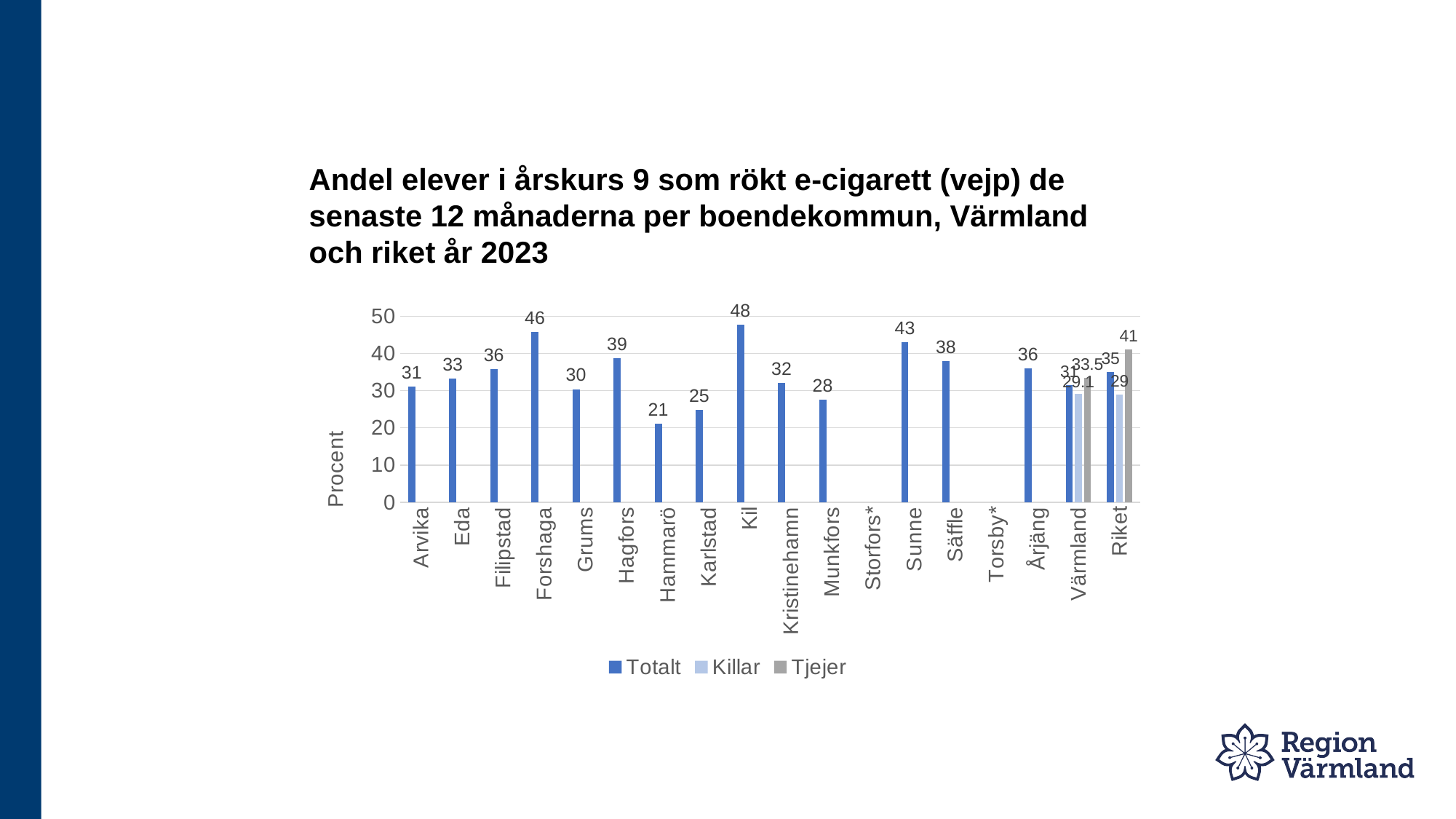
How many series does the legend list? 3 How many categories are shown on the x axis? 18 What is the Tjejer value for Riket? 41 What is the difference between the Tjejer and Killar values for Riket? 12 Which municipality has the highest Totalt value? Kil What is the Totalt value for Kil? 48 What is the Killar value for Värmland? 29.1 What are the three legend entries of the chart? Totalt, Killar, Tjejer What is the difference between the Totalt values for Forshaga and Grums? 16 Which has a higher Totalt value, Sunne or Säffle? Sunne Which municipality has the lowest plotted Totalt value? Hammarö What kind of chart is shown on the slide? Bar chart